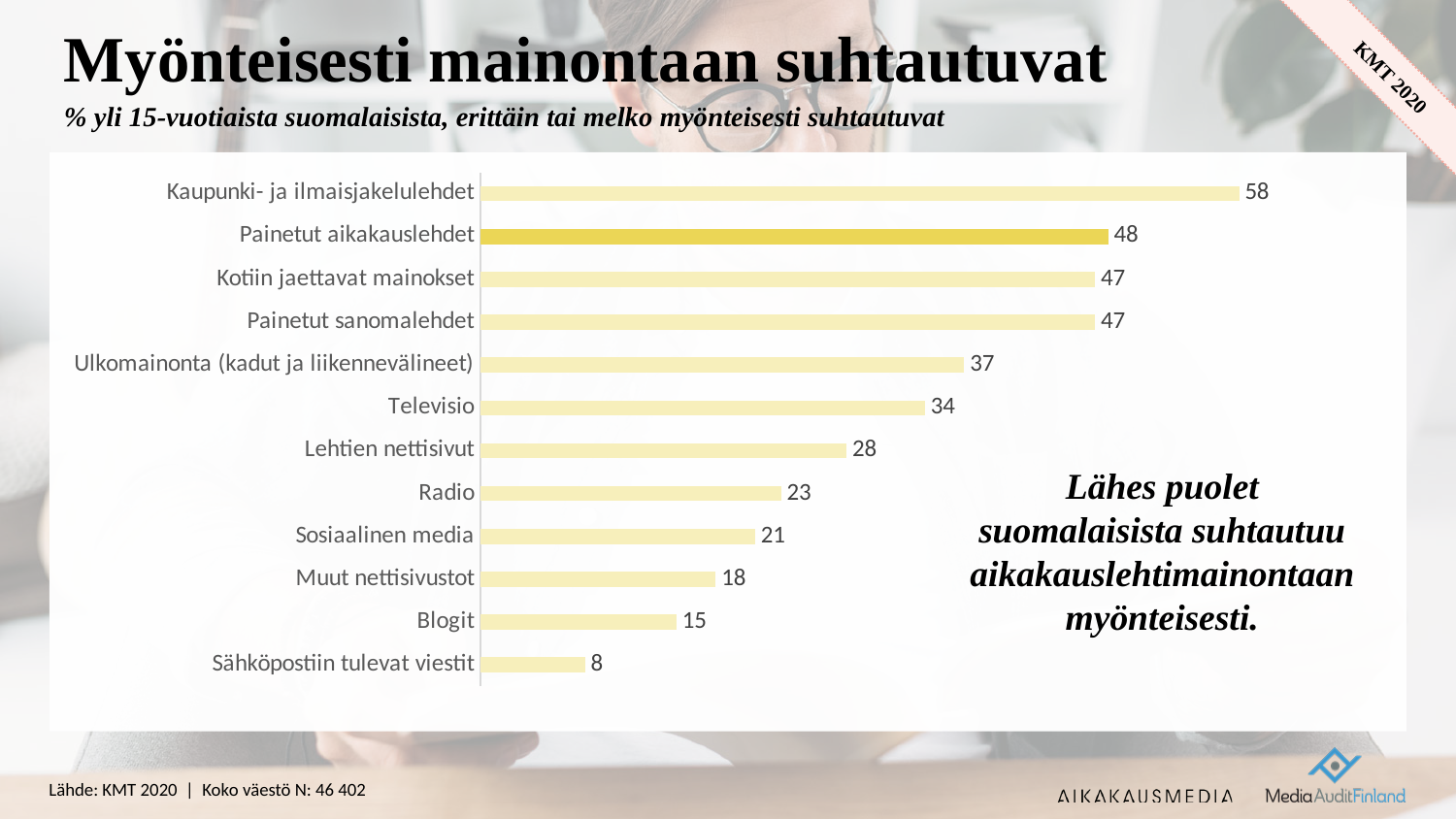
What kind of chart is shown on the slide? Bar chart What is the difference between the values for Ulkomainonta (kadut ja liikennevälineet) and Lehtien nettisivut? 9 How many categories are shown in the chart? 12 What is the difference between the values for Kaupunki- ja ilmaisjakelulehdet and Painetut aikakauslehdet? 10 Which bar is highlighted in a darker yellow colour than the others? Painetut aikakauslehdet What is the value for Sosiaalinen media? 21 Which is larger, the value for Radio or the value for Blogit? Radio What is the value for Muut nettisivustot? 18 Which category has the lowest value? Sähköpostiin tulevat viestit Which category has the highest value? Kaupunki- ja ilmaisjakelulehdet What is the value for Painetut aikakauslehdet? 48 What is the value for Televisio? 34